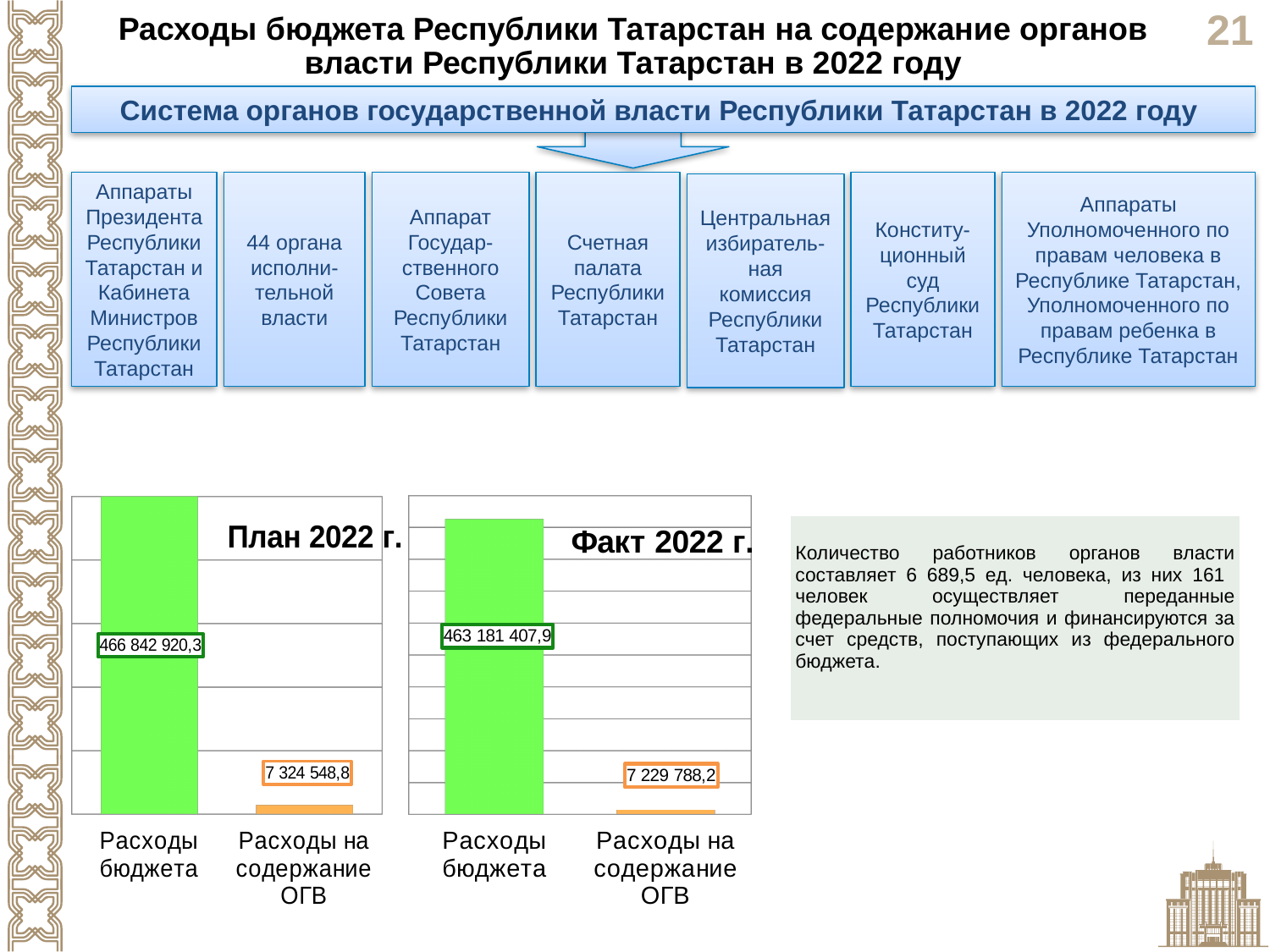
In the "План 2022 г." chart, what is the value for "Расходы на содержание ОГВ"? 7 324 548,8 In the "Факт 2022 г." chart, what is the value for "Расходы бюджета"? 463 181 407,9 In the "План 2022 г." chart, what is the difference between "Расходы бюджета" and "Расходы на содержание ОГВ"? 459 518 371,5 In the "Факт 2022 г." chart, what is the value for "Расходы на содержание ОГВ"? 7 229 788,2 In the "Факт 2022 г." chart, which category has the lowest value? Расходы на содержание ОГВ What colour is the "Расходы бюджета" bar in the "Факт 2022 г." chart? Green In the "Факт 2022 г." chart, what is the difference between "Расходы бюджета" and "Расходы на содержание ОГВ"? 455 951 619,7 In the "План 2022 г." chart, what is the value for "Расходы бюджета"? 466 842 920,3 How many categories are shown in the "Факт 2022 г." chart? 2 Which is larger: "Расходы бюджета" in the "План 2022 г." chart or "Расходы бюджета" in the "Факт 2022 г." chart? План 2022 г. What type of chart is the "План 2022 г." chart? Bar chart In the "План 2022 г." chart, which category has the highest value? Расходы бюджета